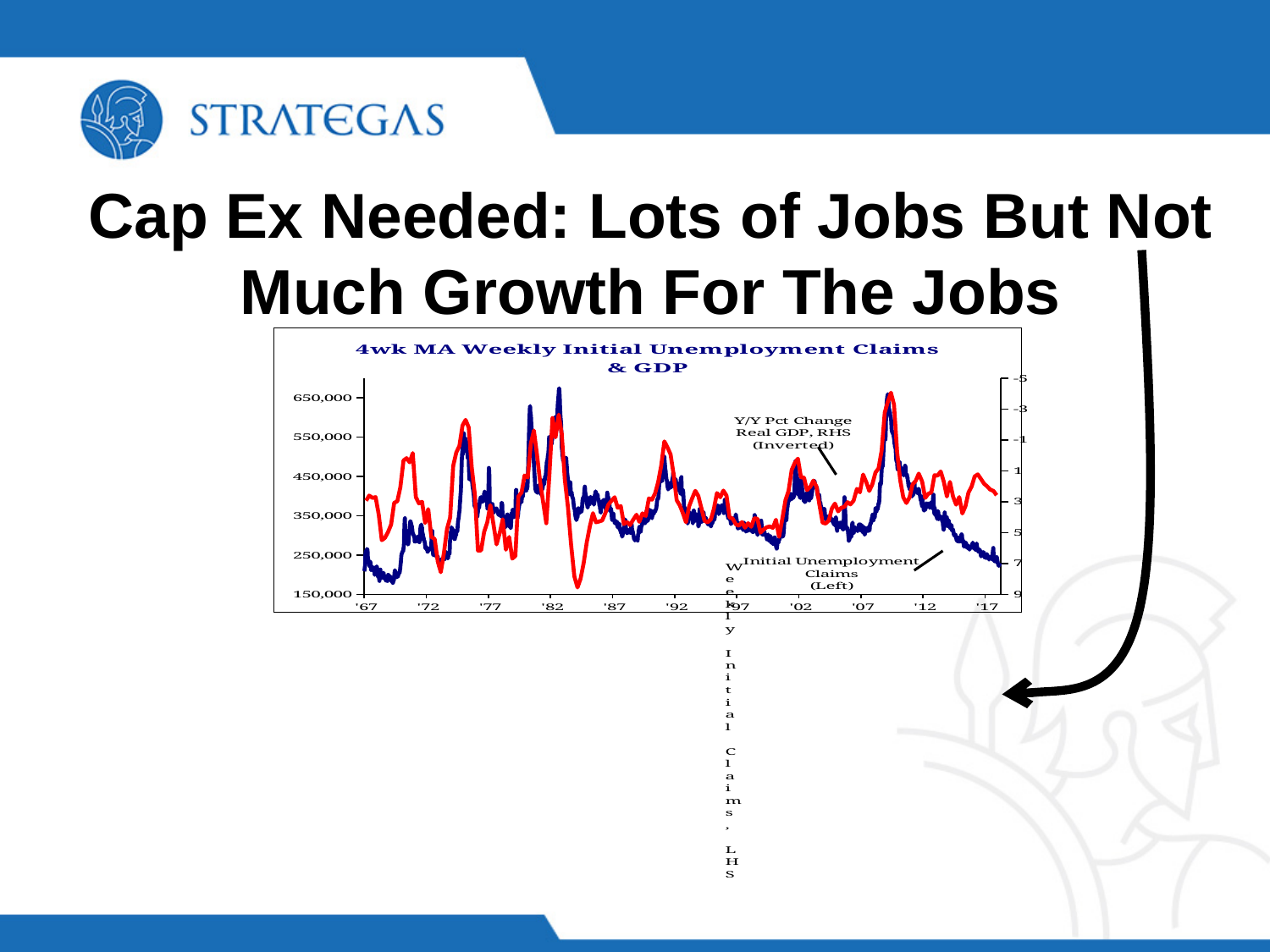
Which series has a higher value on the left axis scale at its peak: Initial Unemployment Claims around '09 or around '92? around '09 Is the peak value of Initial Unemployment Claims around '82 greater or less than 550,000? greater What kind of chart is shown on the slide? line chart How many year labels are shown along the x axis? 11 Is the value of Initial Unemployment Claims around '07 greater or less than 350,000? less Does the Initial Unemployment Claims line rise or fall between '07 and its peak around '09? rise What is the title of the chart? 4wk MA Weekly Initial Unemployment Claims & GDP Is the peak value of Initial Unemployment Claims around '92 greater or less than 450,000? greater Which series is plotted against the right-hand axis? Y/Y Pct Change Real GDP How many data series are plotted on the chart? 2 Does the Initial Unemployment Claims line rise or fall between '12 and '17? fall